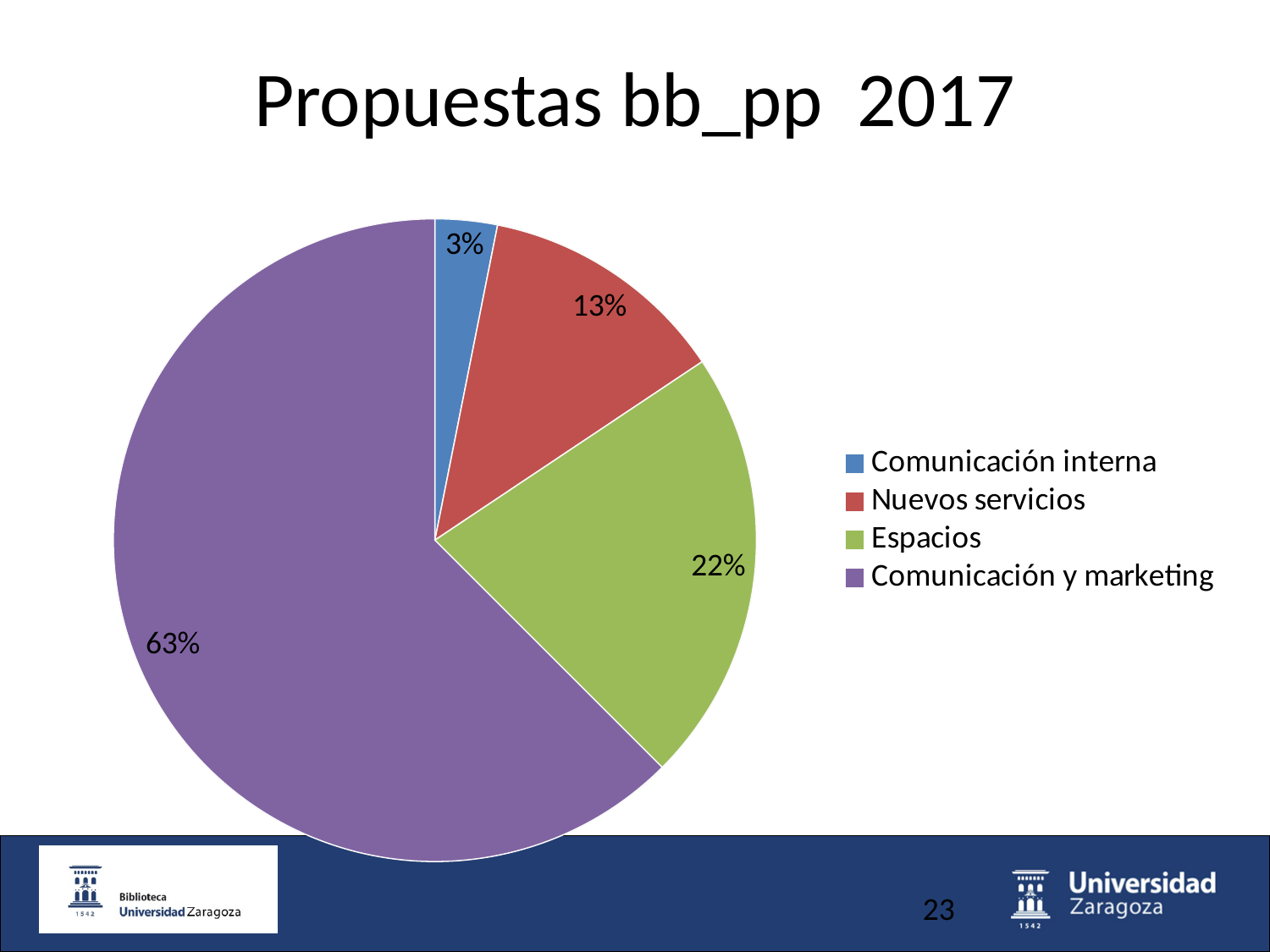
Which category has the largest slice of the pie? Comunicación y marketing What share of the pie does Comunicación interna represent? 3% What is the difference in percentage points between Espacios and Nuevos servicios? 9 What share of the pie does Nuevos servicios represent? 13% Which category has the smallest slice of the pie? Comunicación interna How many categories does the pie chart have? 4 Which is larger, the slice for Nuevos servicios or the slice for Espacios? Espacios What is the difference in percentage points between Comunicación y marketing and Espacios? 41 What share of the pie does Comunicación y marketing represent? 63% What is the title of the chart on the slide? Propuestas bb_pp 2017 What type of chart is shown on the slide? pie chart